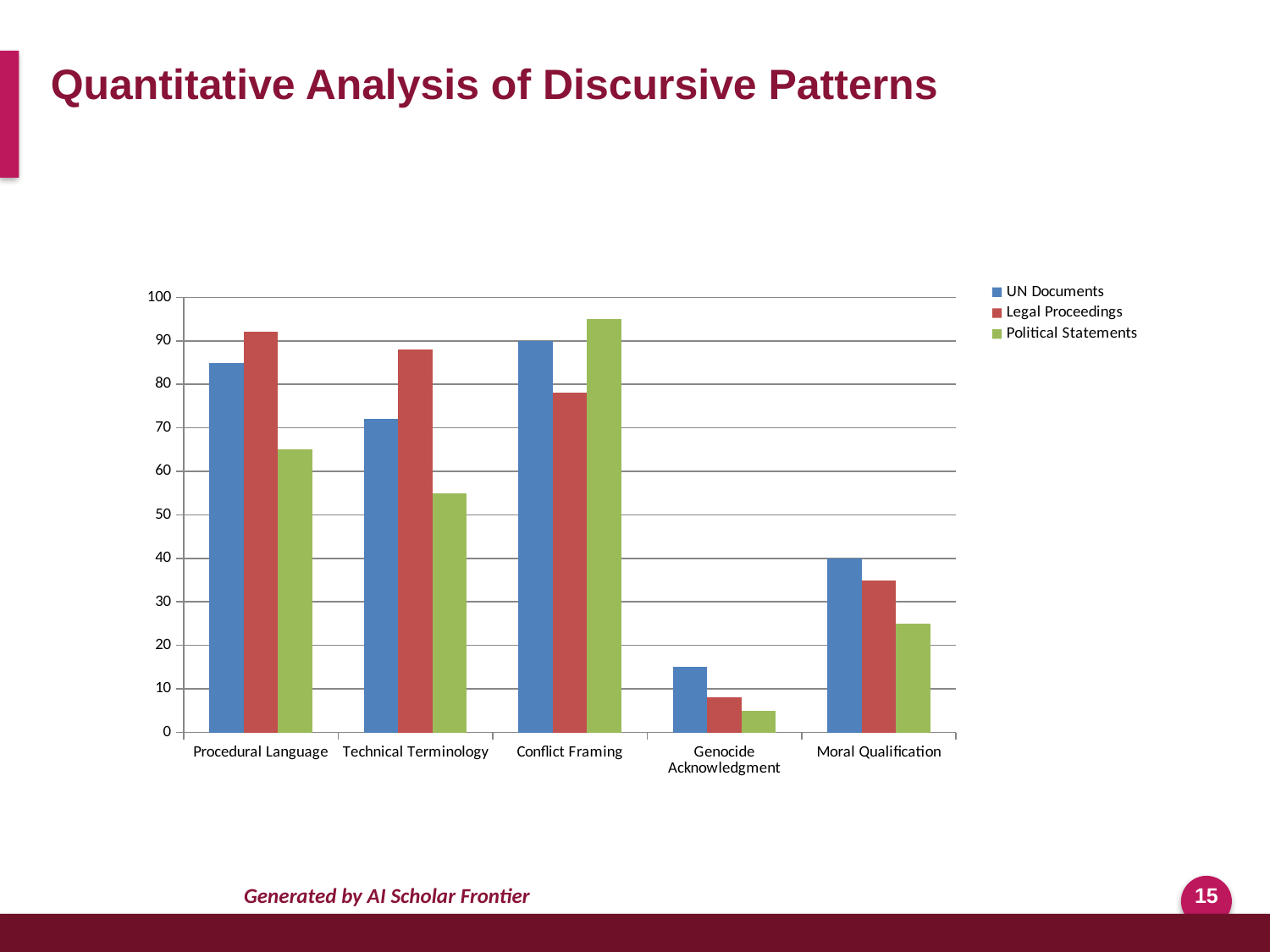
What is the value for UN Documents in the Conflict Framing category? 90 In the Procedural Language category, which is larger: UN Documents or Political Statements? UN Documents How many categories are shown on the x axis? 5 How many series does the legend list? 3 What kind of chart is shown on the slide? bar chart Which category has the highest value for the Political Statements series? Conflict Framing Is the value for Political Statements in Genocide Acknowledgment greater or less than 10? less Which category has the lowest value for the UN Documents series? Genocide Acknowledgment What is the title of the slide containing the chart? Quantitative Analysis of Discursive Patterns What is the value for UN Documents in the Moral Qualification category? 40 Is the value for Political Statements in Technical Terminology greater or less than 60? less Is the value for Legal Proceedings in Procedural Language greater or less than 90? greater